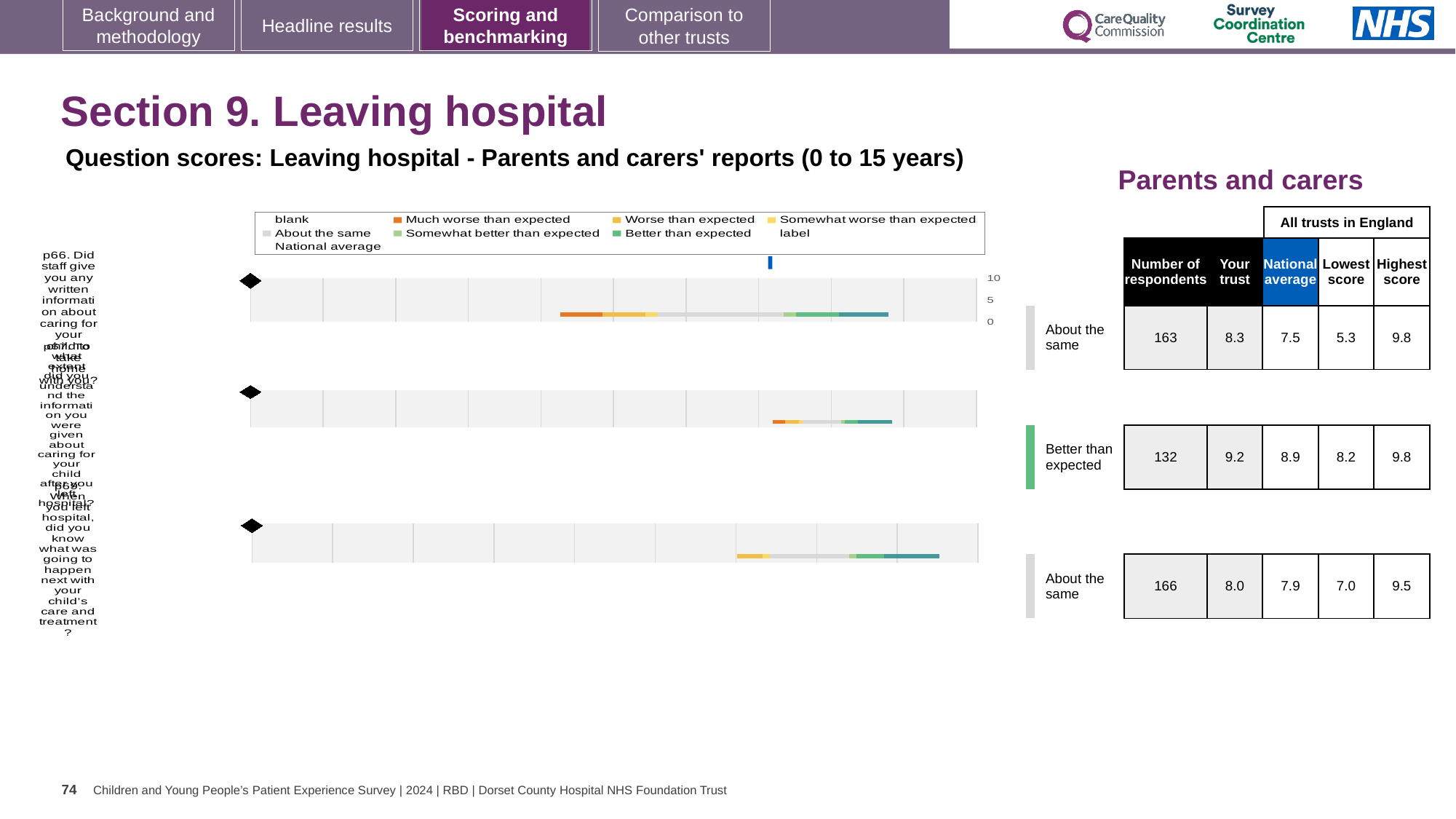
For the middle chart, what is the national average score shown in the table? 8.9 Which legend entry is shown in orange? Much worse than expected For the middle chart, what is the 'Your trust' score shown in the table? 9.2 For the bottom chart, what is the 'Your trust' score shown in the table? 8.0 What kind of chart is used to show the question scores on this slide? bar chart For the top chart, what is the 'Your trust' score shown in the table? 8.3 How many separate question-score bar charts are shown on the slide? 3 Which of the three charts has the highest 'Your trust' score? the middle chart What is the title of the chart section on the slide? Question scores: Leaving hospital - Parents and carers' reports (0 to 15 years) For the top chart, what is the number of respondents shown in the table? 163 What benchmark rating is given for the middle chart? Better than expected For the middle chart, what is the difference between the 'Your trust' score and the national average? 0.3